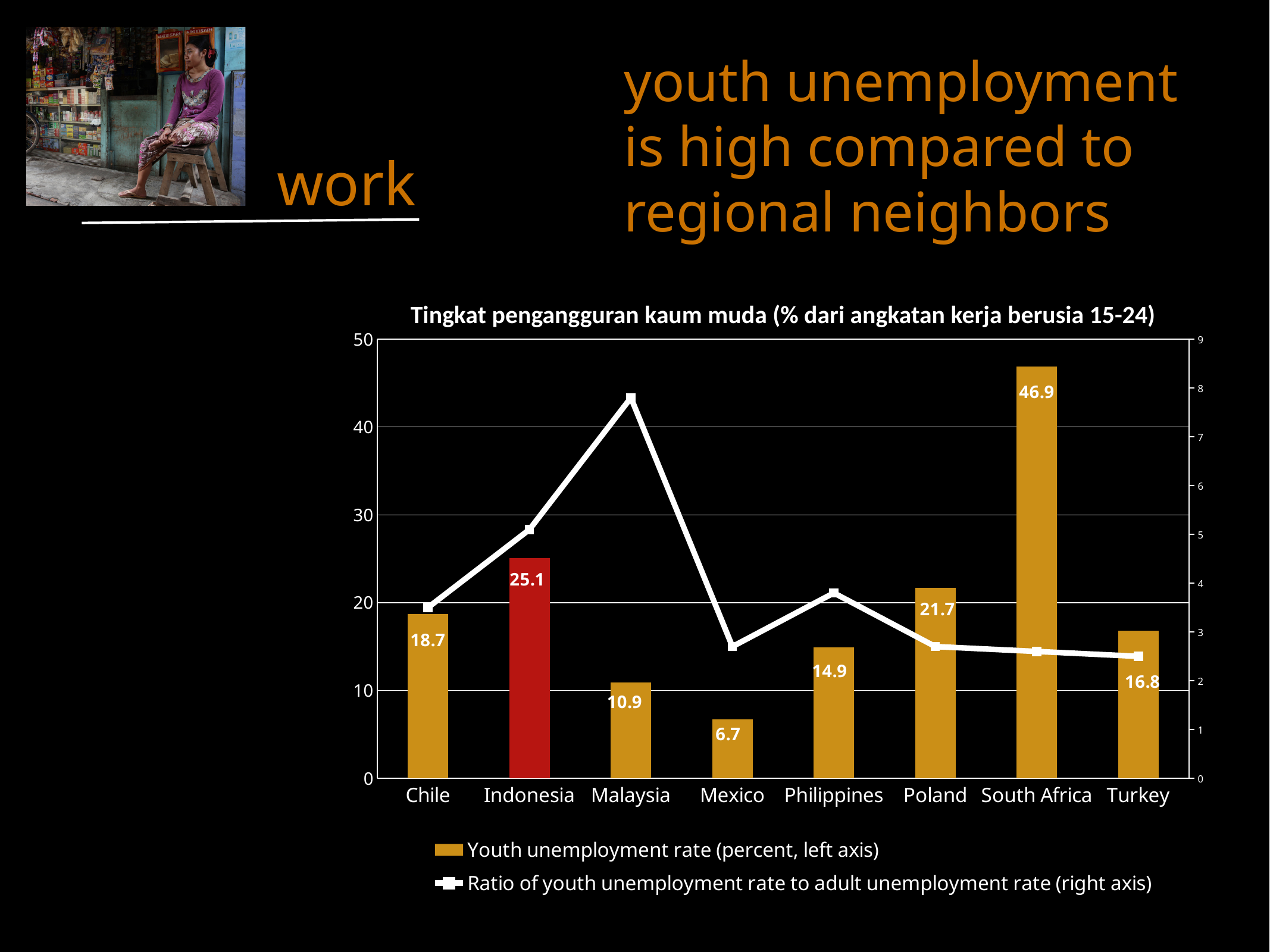
What is the youth unemployment rate for South Africa? 46.9 Which has a higher youth unemployment rate, Poland or Chile? Poland What is the difference between the youth unemployment rates of Indonesia and Malaysia? 14.2 How many countries are shown on the chart? 8 How many series does the legend list? 2 Which country has the lowest youth unemployment rate? Mexico Is the ratio of youth to adult unemployment rate for Malaysia greater or less than 7? greater Which country's bar is coloured red instead of orange? Indonesia Which country has the highest ratio of youth unemployment rate to adult unemployment rate? Malaysia What is the youth unemployment rate for Indonesia? 25.1 Is the ratio of youth to adult unemployment rate for Mexico greater or less than 3? less Which country has the highest youth unemployment rate? South Africa